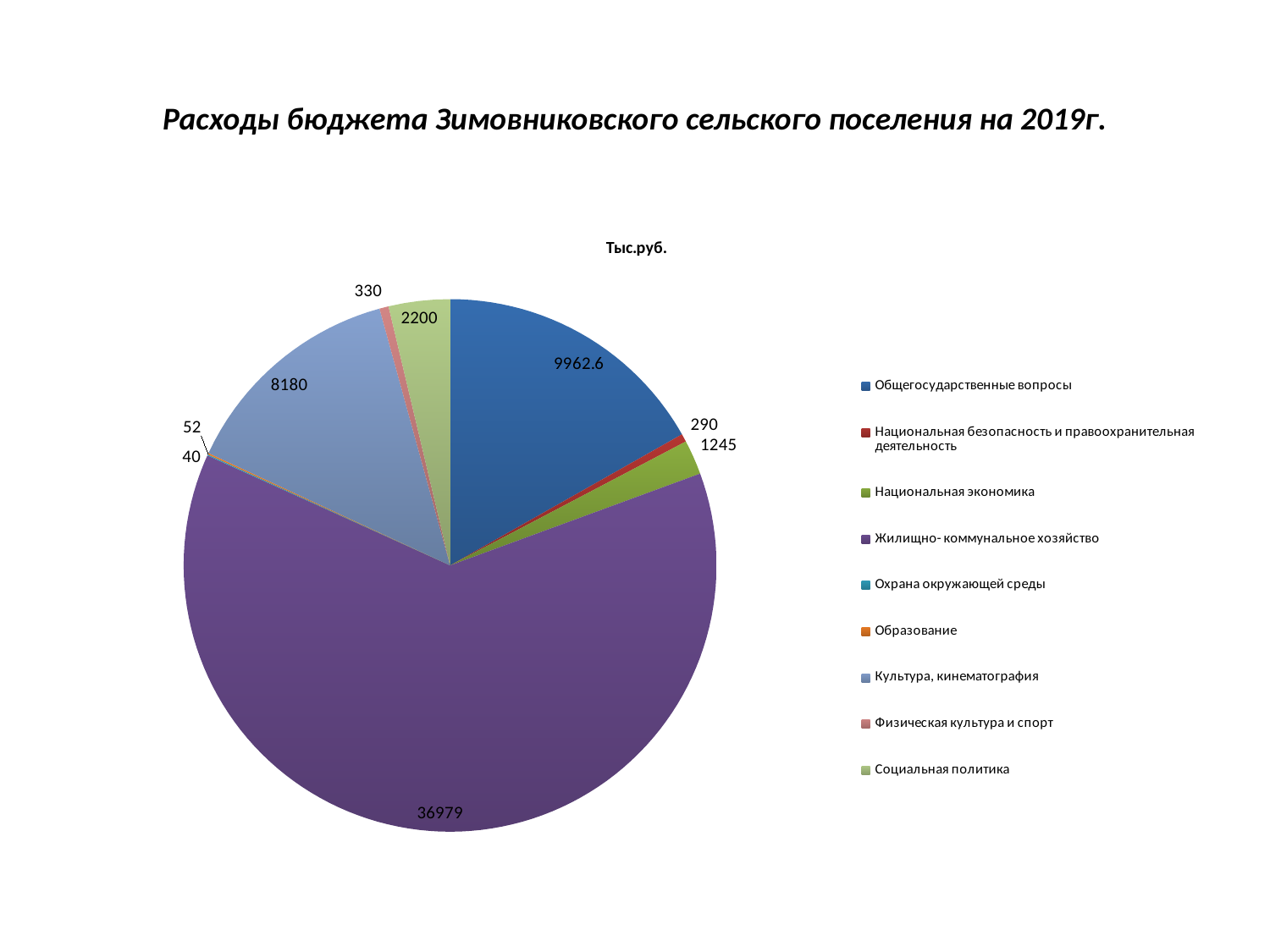
Which category has the largest slice of the pie? Жилищно- коммунальное хозяйство What is the value for Культура, кинематография? 8180 What is the value for Жилищно- коммунальное хозяйство? 36979 What is the difference between the values for Национальная экономика and Национальная безопасность и правоохранительная деятельность? 955 What type of chart is shown on the slide? pie chart What is the value for Национальная экономика? 1245 What is the value for Физическая культура и спорт? 330 Which is larger, Культура, кинематография or Социальная политика? Культура, кинематография How many entries does the legend list? 9 What is the value for Социальная политика? 2200 What unit label is shown above the pie chart? Тыс.руб. What is the value for Общегосударственные вопросы? 9962.6